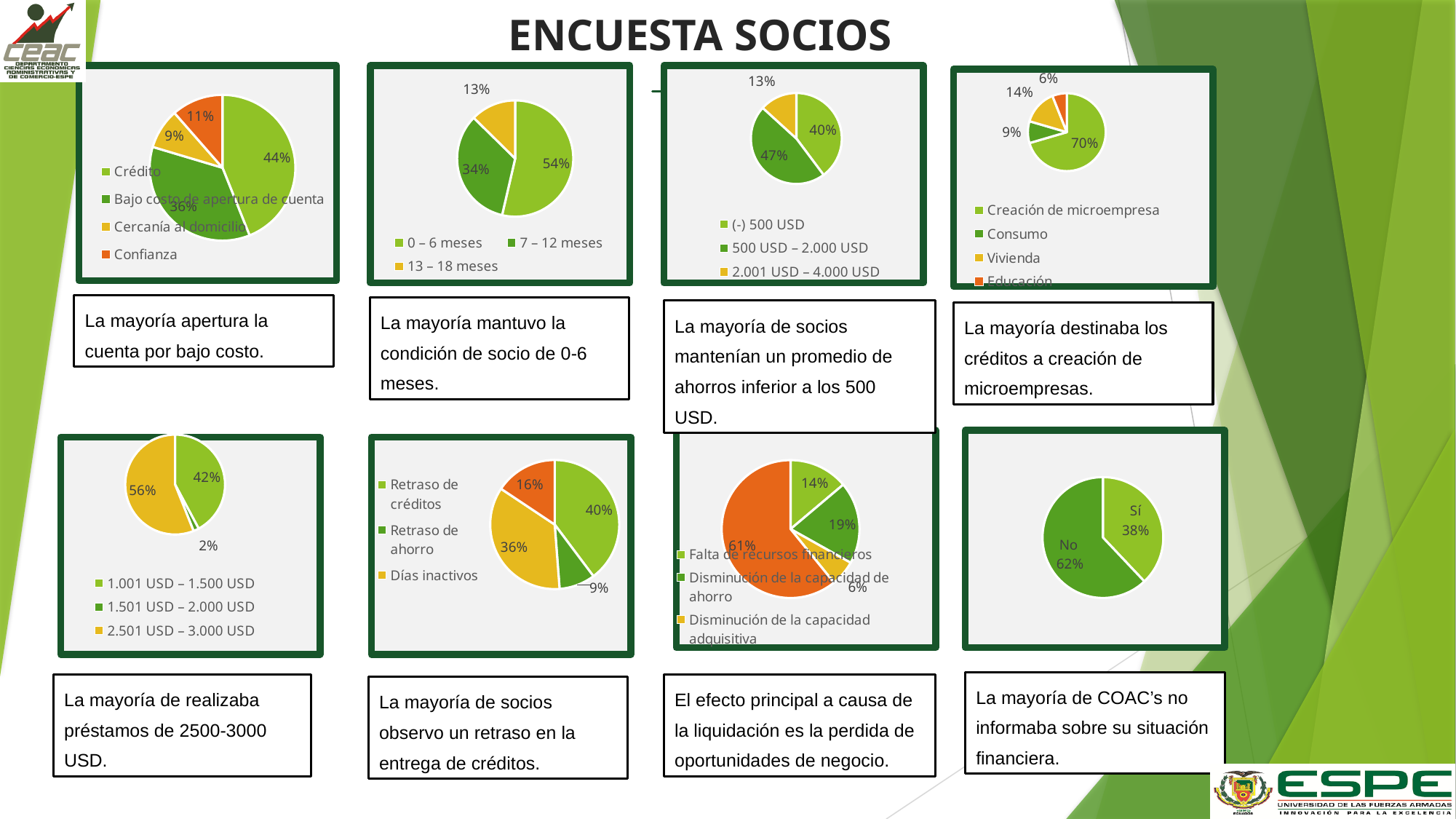
In the second pie chart of the bottom row, what percentage is shown for Días inactivos? 36% In the top-right pie chart, which is larger, Vivienda or Consumo? Vivienda In the second pie chart of the top row, how many categories does the legend list? 3 In the second pie chart of the top row, what percentage corresponds to 0 – 6 meses? 54% In the top-left pie chart, which category has the smallest share? Cercanía al domicilio In the bottom-left pie chart, what percentage corresponds to 1.501 USD – 2.000 USD? 2% In the third pie chart of the top row, which category has the largest share? 500 USD – 2.000 USD In the third pie chart of the top row, what is the difference between the shares of 500 USD – 2.000 USD and (-) 500 USD? 7% What type of chart is the bottom-right chart showing Sí and No? Pie chart In the third pie chart of the bottom row, what percentage is shown for Disminución de la capacidad de ahorro? 19% In the top-right pie chart, what percentage is shown for Creación de microempresa? 70% In the top-left pie chart, what percentage is shown for Crédito? 44%